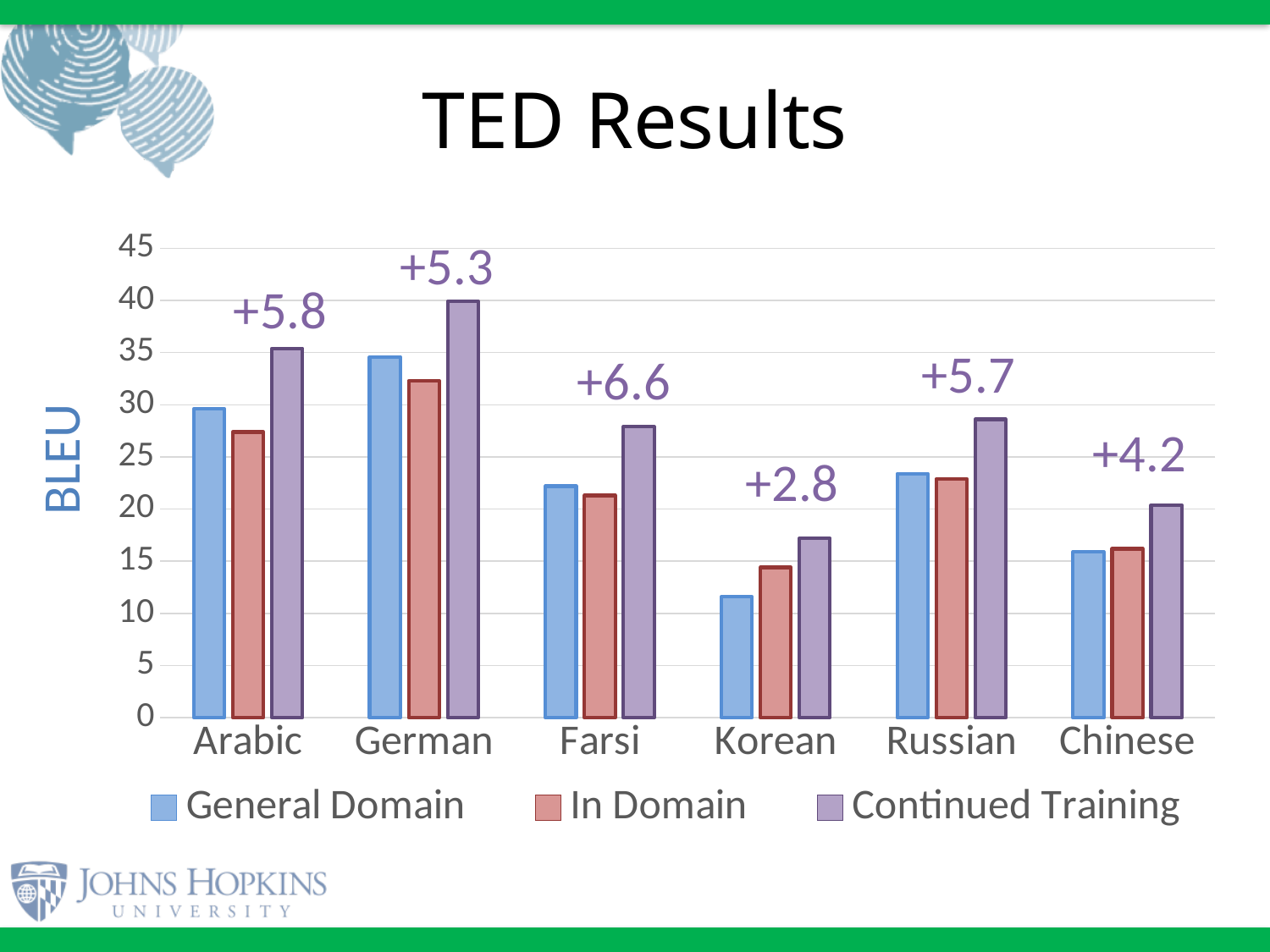
What improvement is annotated above the Chinese bars? +4.2 Is the Continued Training value for Korean greater or less than 20? less Is the Continued Training value for Russian greater or less than 25? greater What improvement is annotated above the Korean bars? +2.8 What is the label on the vertical axis of the chart? BLEU How many languages are shown on the x axis of the chart? 6 What improvement is annotated above the Farsi bars? +6.6 For Arabic, which is larger: the General Domain score or the In Domain score? General Domain What kind of chart is shown on the slide? bar chart Which language has the lowest General Domain BLEU score? Korean How many series does the chart's legend list? 3 Which language has the highest Continued Training BLEU score? German